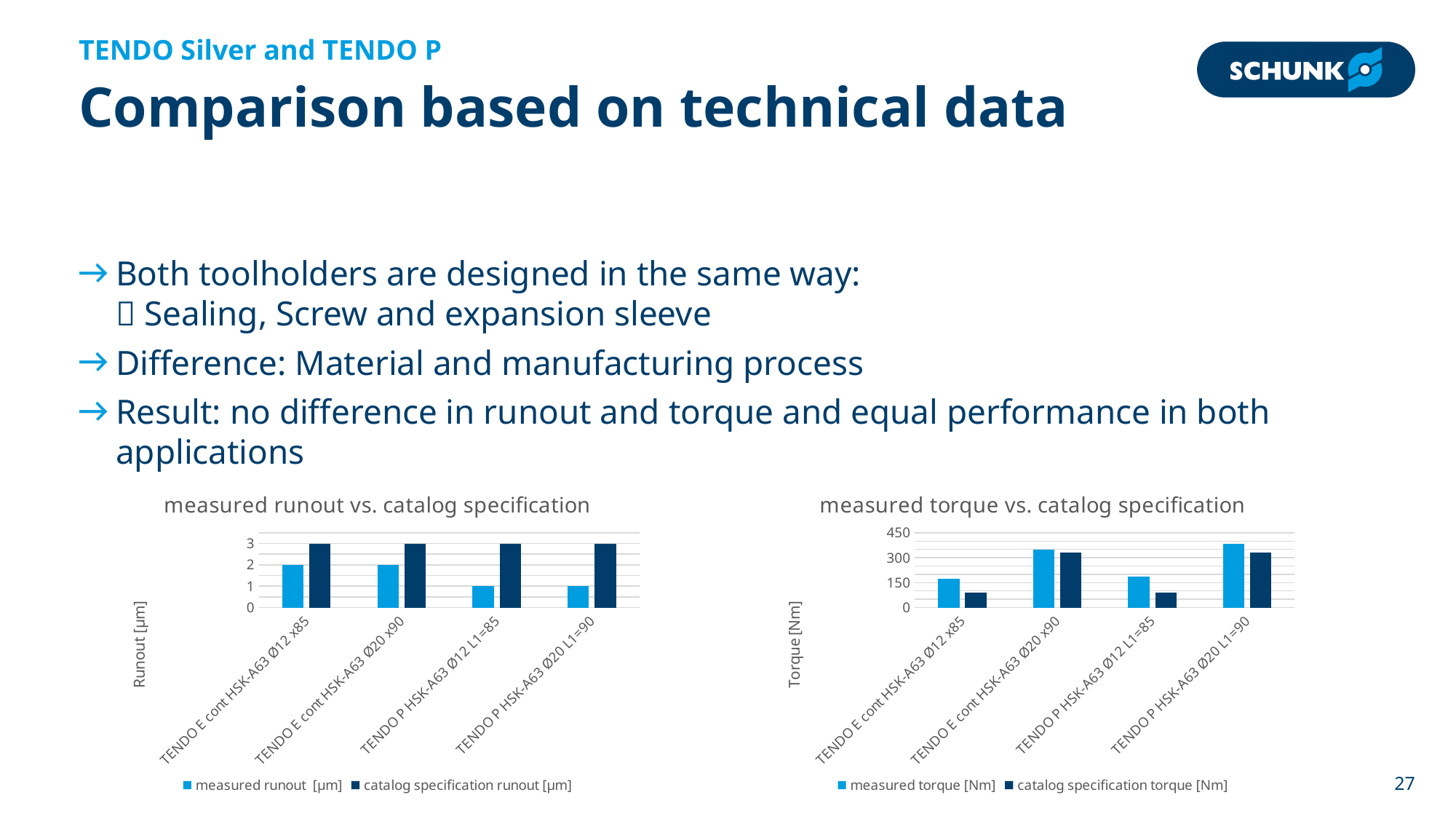
In the 'measured torque vs. catalog specification' chart, which is larger for TENDO P HSK-A63 Ø12 L1=85: the measured torque or the catalog specification torque? measured torque In the 'measured runout vs. catalog specification' chart, what is the measured runout for TENDO P HSK-A63 Ø12 L1=85? 1 In the 'measured runout vs. catalog specification' chart, what is the catalog specification runout for TENDO P HSK-A63 Ø20 L1=90? 3 In the 'measured runout vs. catalog specification' chart, what is the difference between the catalog specification runout and the measured runout for TENDO E cont HSK-A63 Ø20 x90? 1 What kind of chart is the 'measured torque vs. catalog specification' chart? bar chart What is the y-axis label of the 'measured torque vs. catalog specification' chart? Torque [Nm] In the 'measured runout vs. catalog specification' chart, how many categories are shown on the x axis? 4 In the 'measured runout vs. catalog specification' chart, how many series does the legend list? 2 In the 'measured torque vs. catalog specification' chart, is the catalog specification torque for TENDO E cont HSK-A63 Ø12 x85 greater or less than 150? less In the 'measured torque vs. catalog specification' chart, which category has the highest measured torque? TENDO P HSK-A63 Ø20 L1=90 In the 'measured runout vs. catalog specification' chart, what is the measured runout for TENDO E cont HSK-A63 Ø12 x85? 2 In the 'measured torque vs. catalog specification' chart, is the measured torque for TENDO P HSK-A63 Ø20 L1=90 greater or less than 300? greater